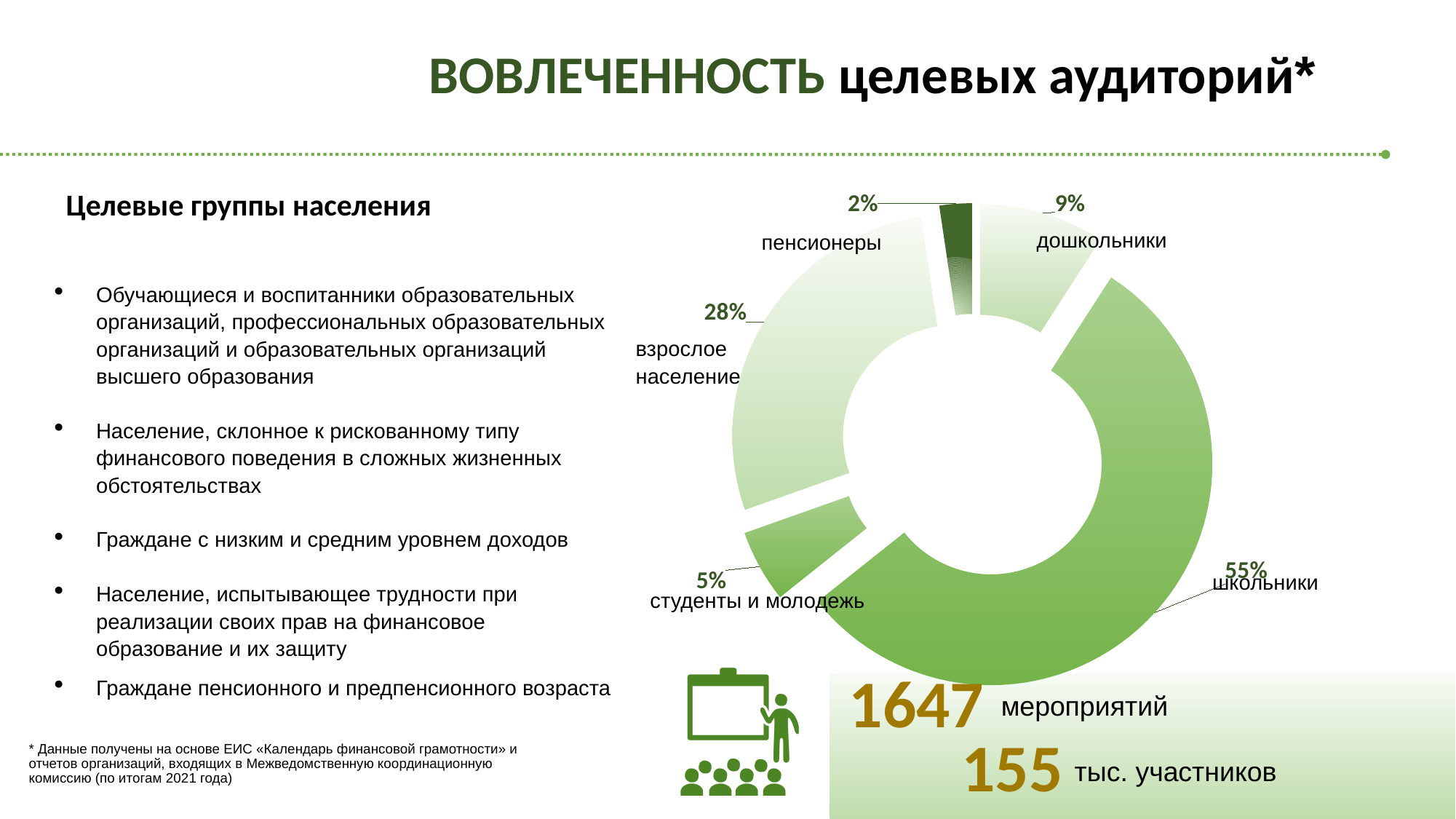
What percentage does the chart show for студенты и молодежь? 5% What percentage does the chart show for пенсионеры? 2% What percentage does the chart show for дошкольники? 9% What is the difference in percentage points between школьники and взрослое население? 27 Which category has the largest share in the chart? школьники How many categories are shown in the chart? 5 Which has a larger share, дошкольники or студенты и молодежь? дошкольники What share of the donut chart is labelled for школьники? 55% Which category has the smallest share in the chart? пенсионеры What is the combined share of дошкольники and пенсионеры? 11% What kind of chart is shown on the slide? Donut (pie) chart What percentage does the chart show for взрослое население? 28%